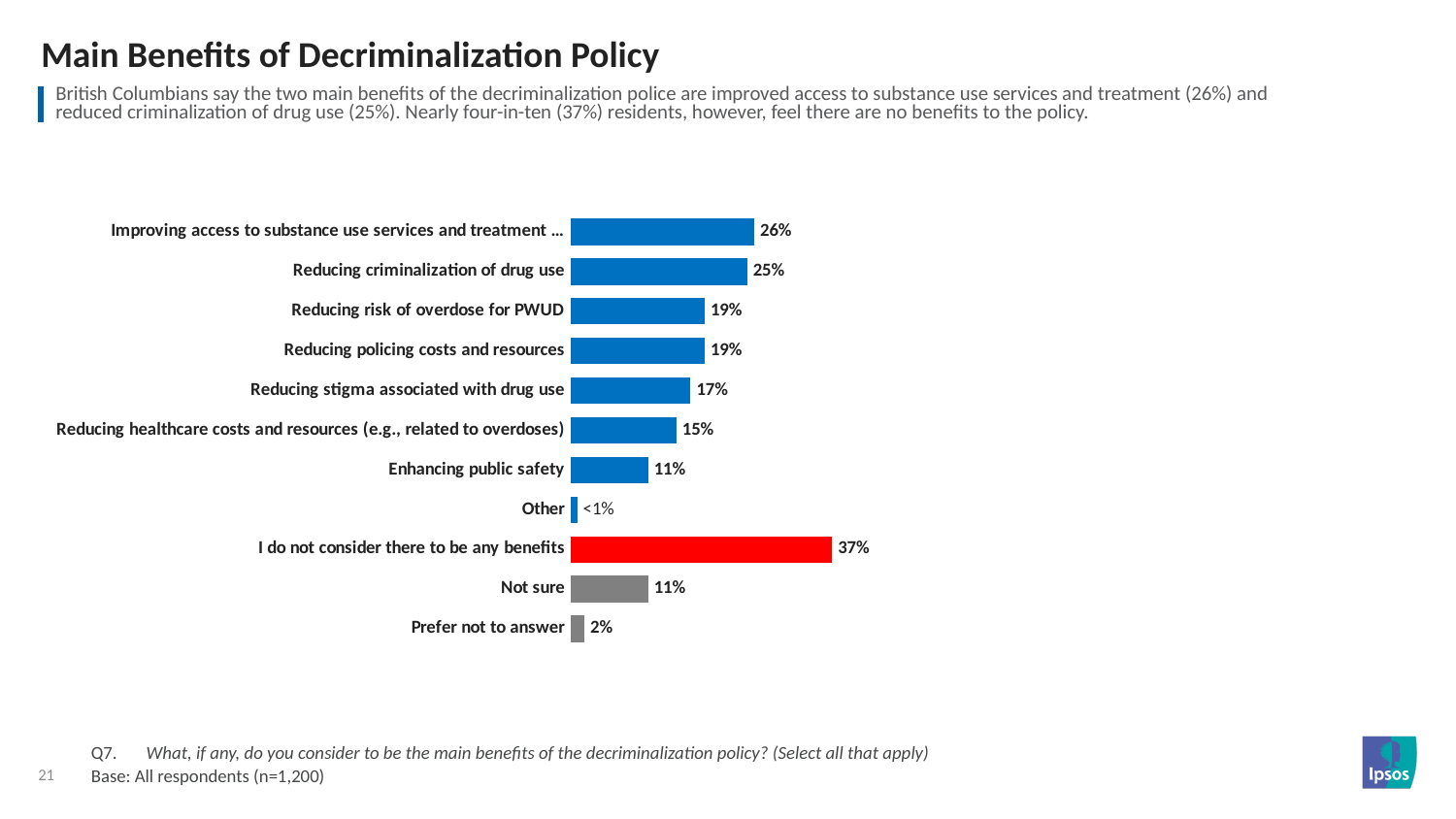
Which category has the highest value in the chart? I do not consider there to be any benefits What type of chart is shown on the slide? Bar chart How many categories are shown in the chart? 11 What value is shown for "Prefer not to answer"? 2% What value is shown for "Reducing healthcare costs and resources (e.g., related to overdoses)"? 15% Which is larger: the value for "Reducing criminalization of drug use" or the value for "Reducing stigma associated with drug use"? Reducing criminalization of drug use What colour is the bar for "I do not consider there to be any benefits"? Red What value is shown for "Reducing stigma associated with drug use"? 17% What percentage is shown for "Enhancing public safety"? 11% Which category has the lowest value in the chart? Other What is the difference between the value for "I do not consider there to be any benefits" and the value for "Improving access to substance use services and treatment ..."? 11 percentage points What percentage of respondents selected "Reducing criminalization of drug use"? 25%